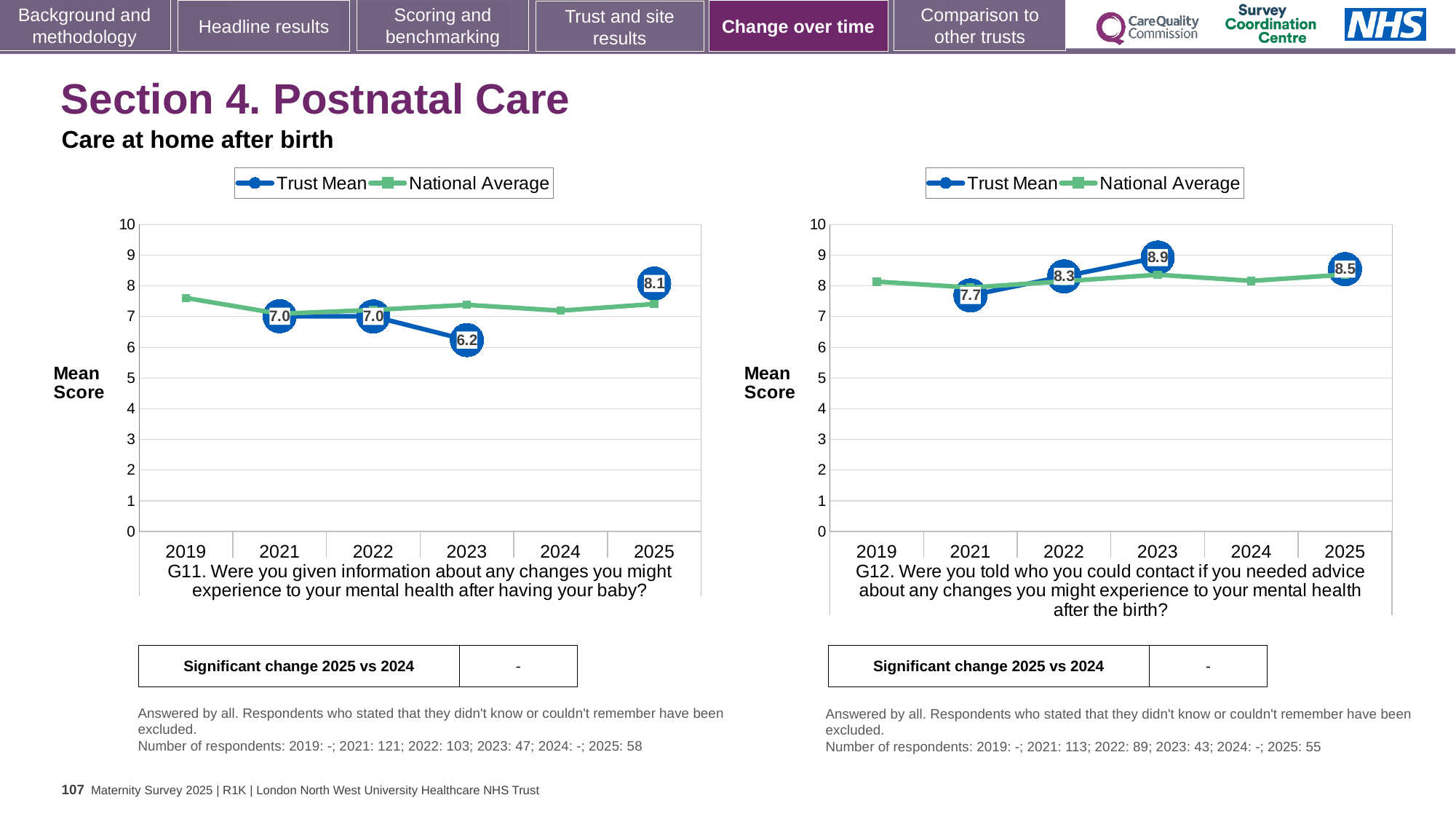
In the G11 chart, what is the Trust Mean score for 2023? 6.2 In the G12 chart, what is the Trust Mean score for 2021? 7.7 In the G11 chart, is the National Average value for 2019 greater or less than 7? greater How many series does the legend of the G12 chart list? 2 What kind of chart is the G11 chart? Line chart In the G12 chart, what is the difference between the Trust Mean scores for 2023 and 2021? 1.2 In the G12 chart, does the Trust Mean rise or fall from 2021 to 2023? Rise In the G12 chart, which year has the highest Trust Mean score? 2023 In the G11 chart, what is the difference between the Trust Mean scores for 2025 and 2023? 1.9 In the G11 chart, which year has the lowest Trust Mean score? 2023 In the G12 chart, is the Trust Mean score higher in 2022 or in 2025? 2025 In the G11 chart, what is the Trust Mean score for 2025? 8.1